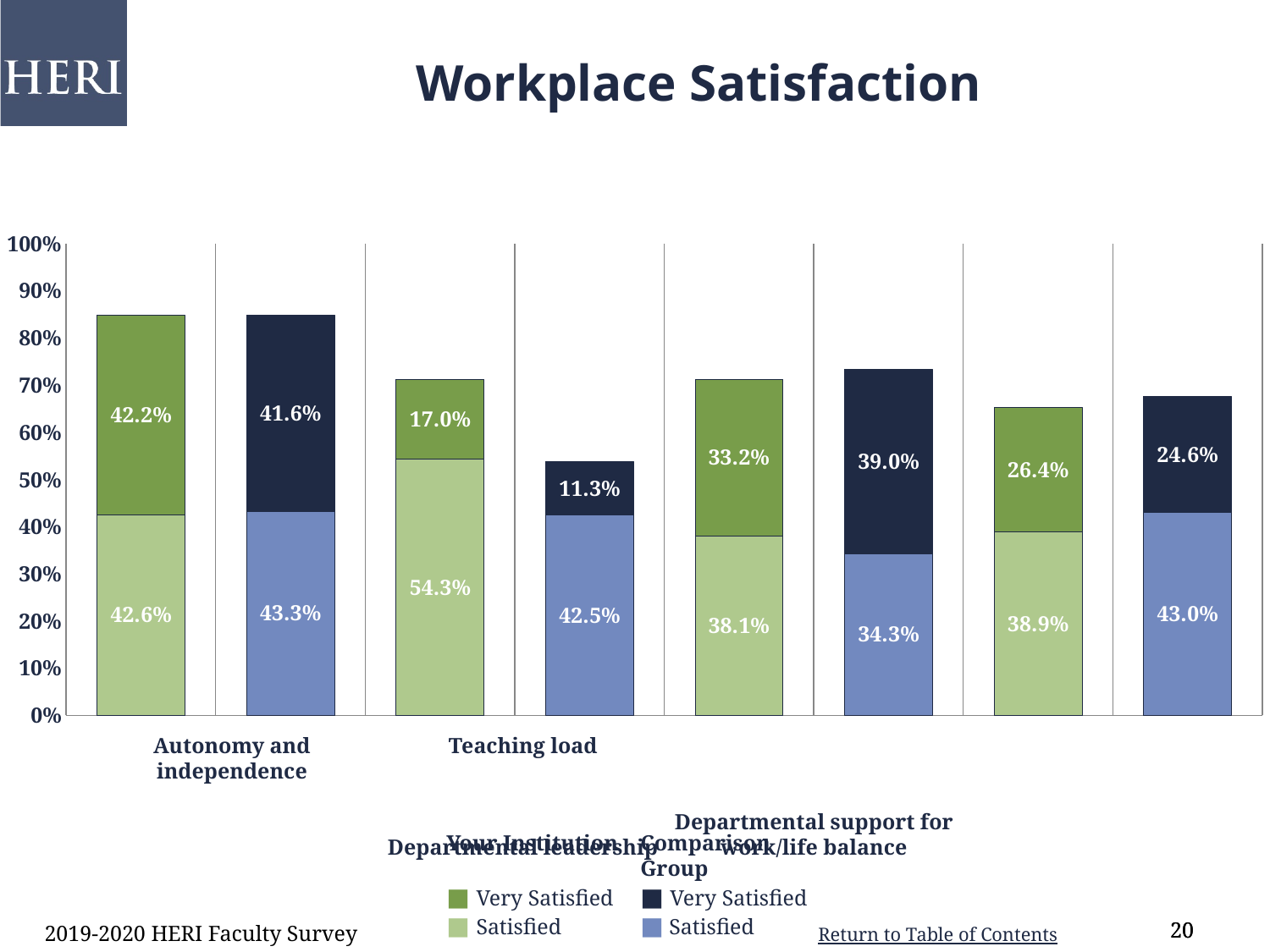
What is the Very Satisfied percentage for Your Institution for Departmental support for work/life balance? 26.4% Which is larger for Teaching load: the Very Satisfied percentage for Your Institution or for the Comparison Group? Your Institution What is the total of the Comparison Group stacked bar for Teaching load? 53.8% What is the Very Satisfied percentage for the Comparison Group for Autonomy and independence? 41.6% What is the Satisfied percentage for Your Institution for Autonomy and independence? 42.6% What is the Satisfied percentage for Your Institution for Teaching load? 54.3% What is the title of the chart? Workplace Satisfaction How many legend entries does the chart list? 4 What type of chart is shown on the slide? Stacked bar chart What is the total of the Your Institution stacked bar for Teaching load? 71.3% What is the difference between the Your Institution and Comparison Group Satisfied percentages for Teaching load? 11.8% What is the Very Satisfied percentage for the Comparison Group for Teaching load? 11.3%